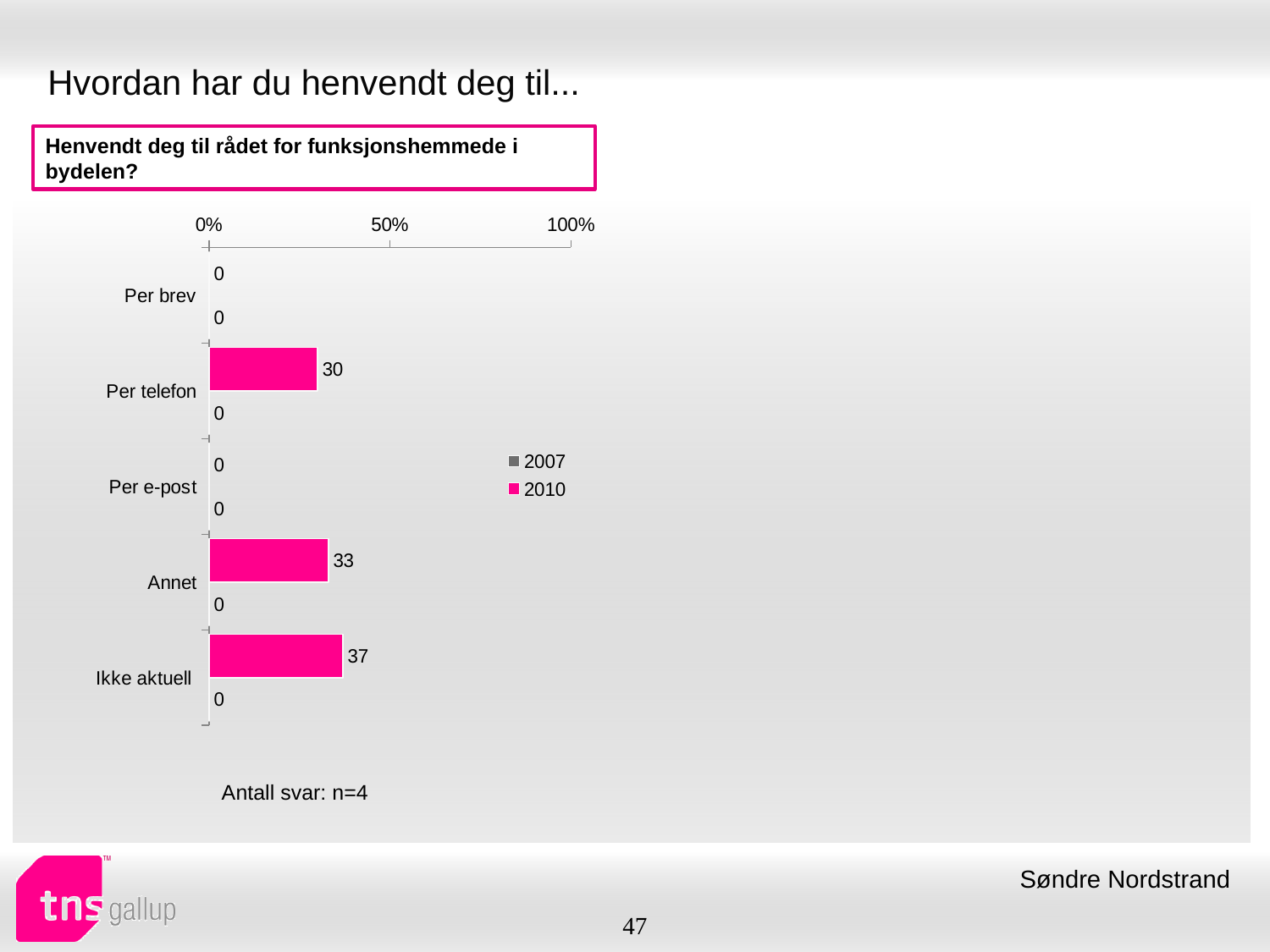
What is the 2010 value for Per telefon? 30 What is the 2010 value for Annet? 33 Which category has the highest 2010 value? Ikke aktuell Which has a larger 2010 value, Annet or Per telefon? Annet How many series does the legend list? 2 Is the 2010 value for Ikke aktuell greater or less than 50%? less Which colour represents the 2010 series in the legend? pink What is the 2007 value for Per telefon? 0 What type of chart is shown on the slide? bar chart How many categories are shown on the chart? 5 What is the 2010 value for Ikke aktuell? 37 What is the difference between the 2010 values for Ikke aktuell and Per telefon? 7